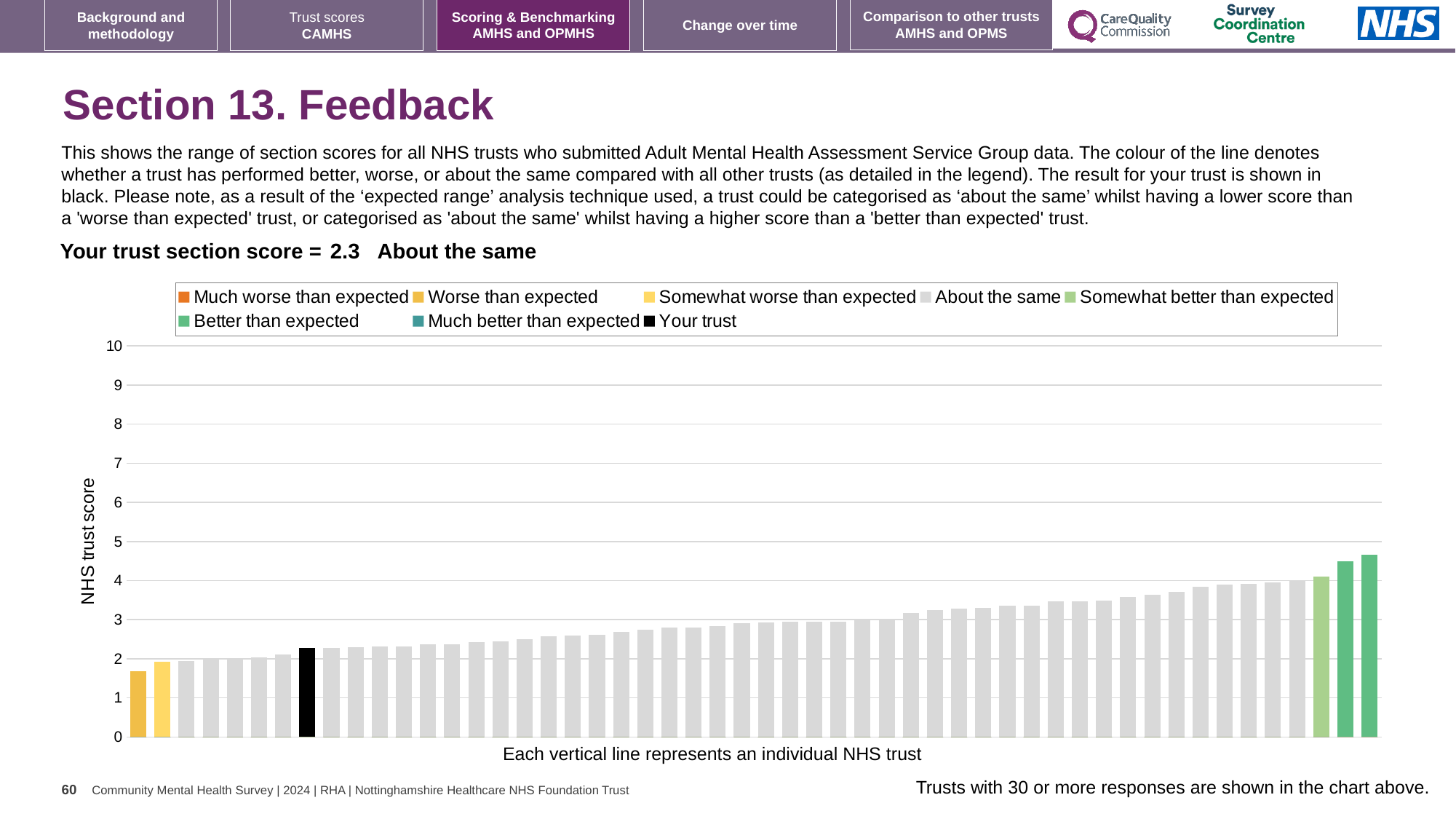
Which category is your trust's section score placed in? About the same What kind of chart is shown on the slide? bar chart Is the value of the tallest bar in the chart greater or less than 4? greater Do the bar values rise or fall from left to right along the x axis? rise What colour is used for the 'Your trust' bar in the chart? black How many entries does the chart legend list? 8 Is the value of the black 'Your trust' bar greater or less than 3? less What is the label on the y axis of the chart? NHS trust score Is the value of the leftmost bar in the chart greater or less than 2? less What is the section score for your trust shown on the slide? 2.3 How many bars in the chart are coloured green? 3 Is the leftmost bar higher or lower than the black 'Your trust' bar? lower